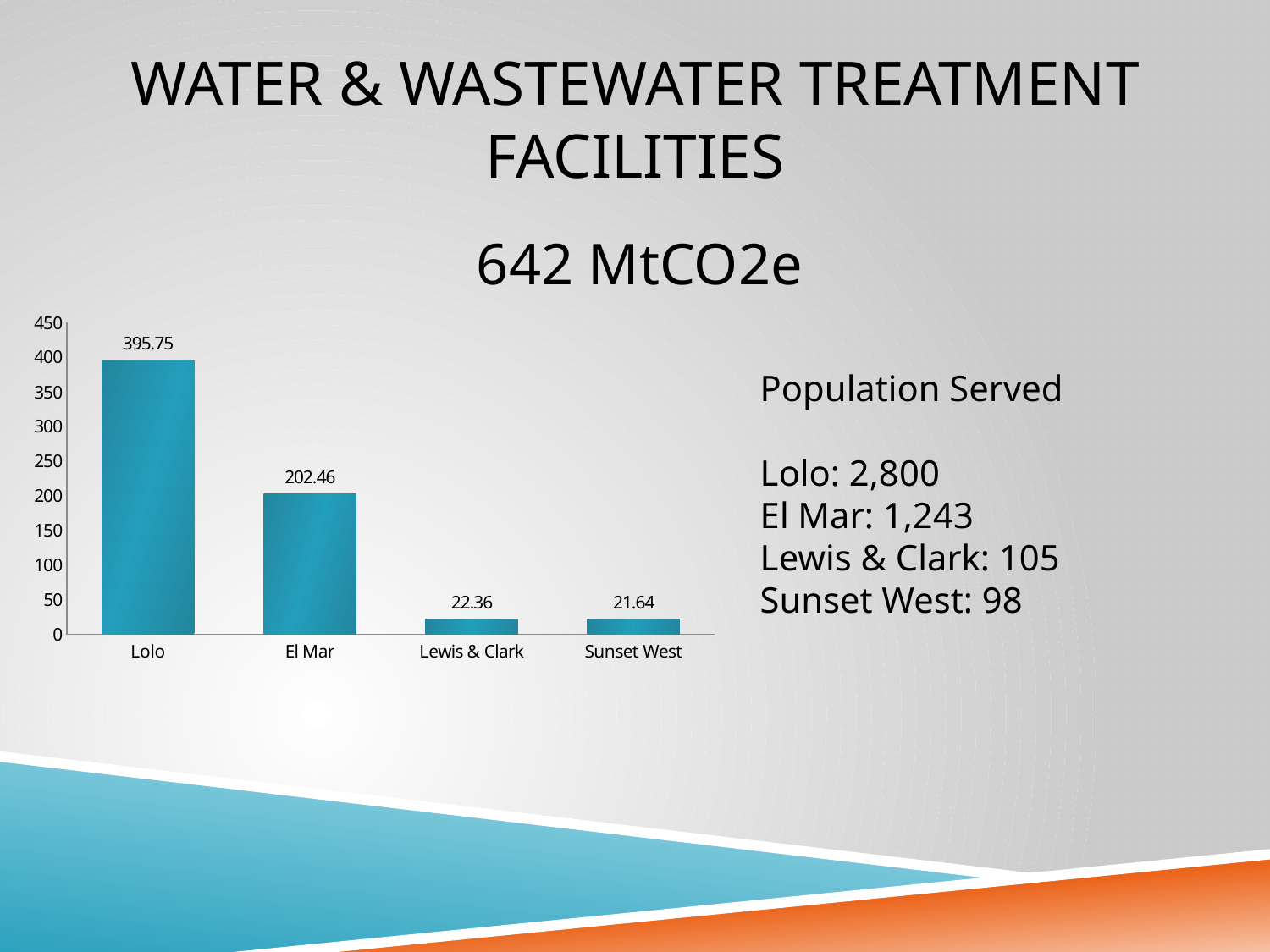
Is the value for Lolo greater or less than 350? greater What is the value for Lolo in the bar chart? 395.75 Which facility has the highest value in the bar chart? Lolo What is the difference between the values for Lewis & Clark and Sunset West? 0.72 How many facilities are shown in the bar chart? 4 What is the value for El Mar in the bar chart? 202.46 What kind of chart is shown on the slide? Bar chart Which is larger, the value for El Mar or the value for Lewis & Clark? El Mar What is the value for Sunset West in the bar chart? 21.64 What is the value for Lewis & Clark in the bar chart? 22.36 Is the value for Lewis & Clark greater or less than 50? less What is the difference between the values for Lolo and El Mar? 193.29